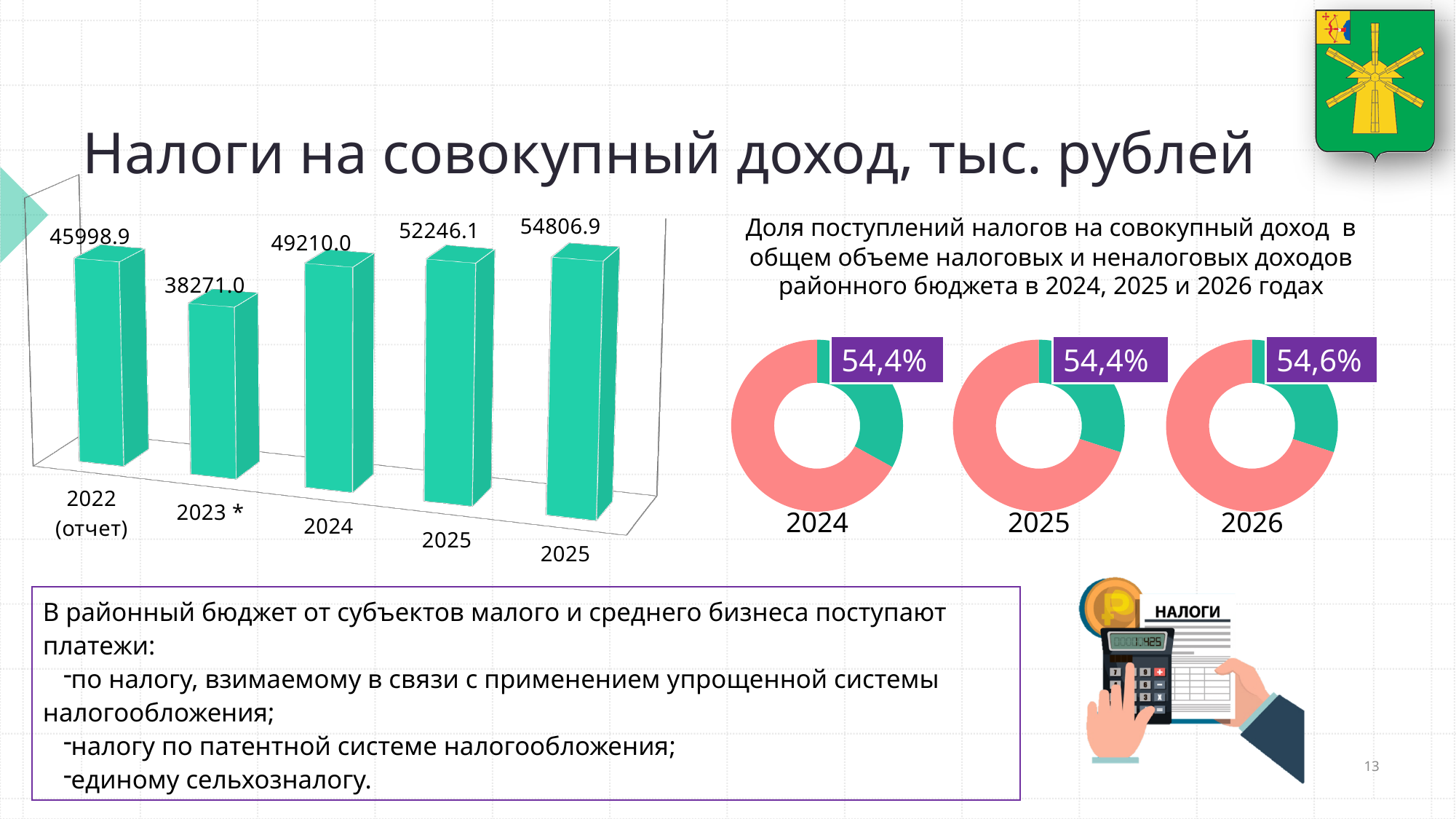
On the bar chart, which is larger: the value for 2024 or the value for 2022 (отчет)? 2024 On the bar chart, what is the value of the rightmost bar? 54806.9 On the donut charts, what share is labelled for 2026? 54,6% On the bar chart, what is the difference between the values for 2022 (отчет) and 2023 *? 7727.9 On the bar chart, what is the value for 2022 (отчет)? 45998.9 On the bar chart, which category has the lowest value? 2023 * On the donut charts, what share is labelled for 2024? 54,4% On the bar chart, which bar has the highest value? The rightmost bar (54806.9) On the bar chart, what is the value for 2023 *? 38271.0 What type of chart is used on the left side of the slide? Bar chart On the bar chart, what is the value for 2024? 49210.0 How many bars are shown on the bar chart? 5